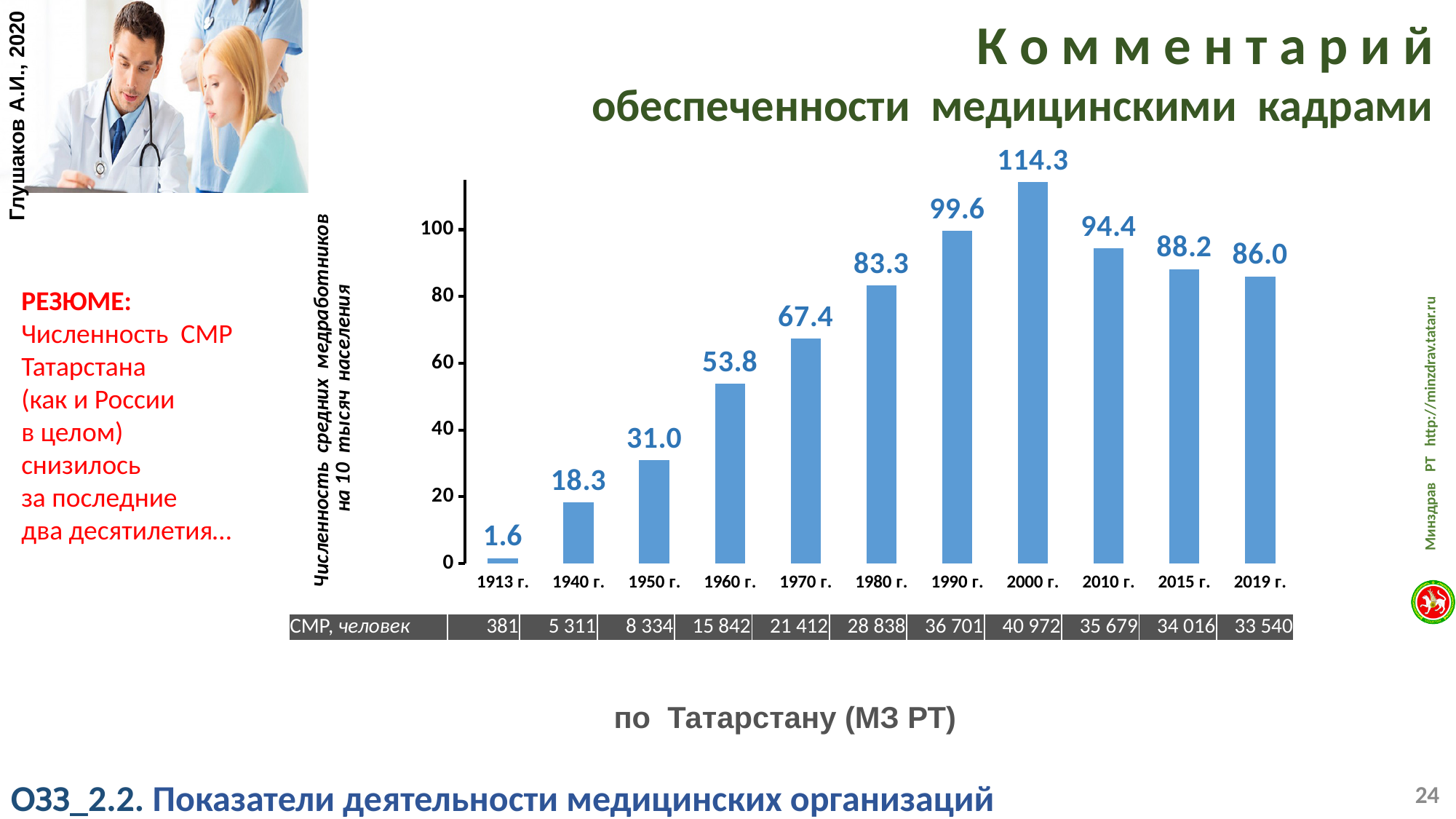
What is the difference between the values for 2000 г. and 2019 г.? 28.3 Which year has the lowest value? 1913 г. Is the value for 1980 г. greater or less than 80? greater In the table row below the chart, what is the СМР, человек value for 2000 г.? 40 972 Which is larger, the value for 1990 г. or the value for 2010 г.? 1990 г. What is the value for 1960 г.? 53.8 What kind of chart is shown? bar chart What is the value for 2000 г.? 114.3 Do the values rise or fall from 1913 г. to 2000 г.? rise What is the value for 2019 г.? 86.0 Which year has the highest value? 2000 г. How many years are shown on the x axis? 11